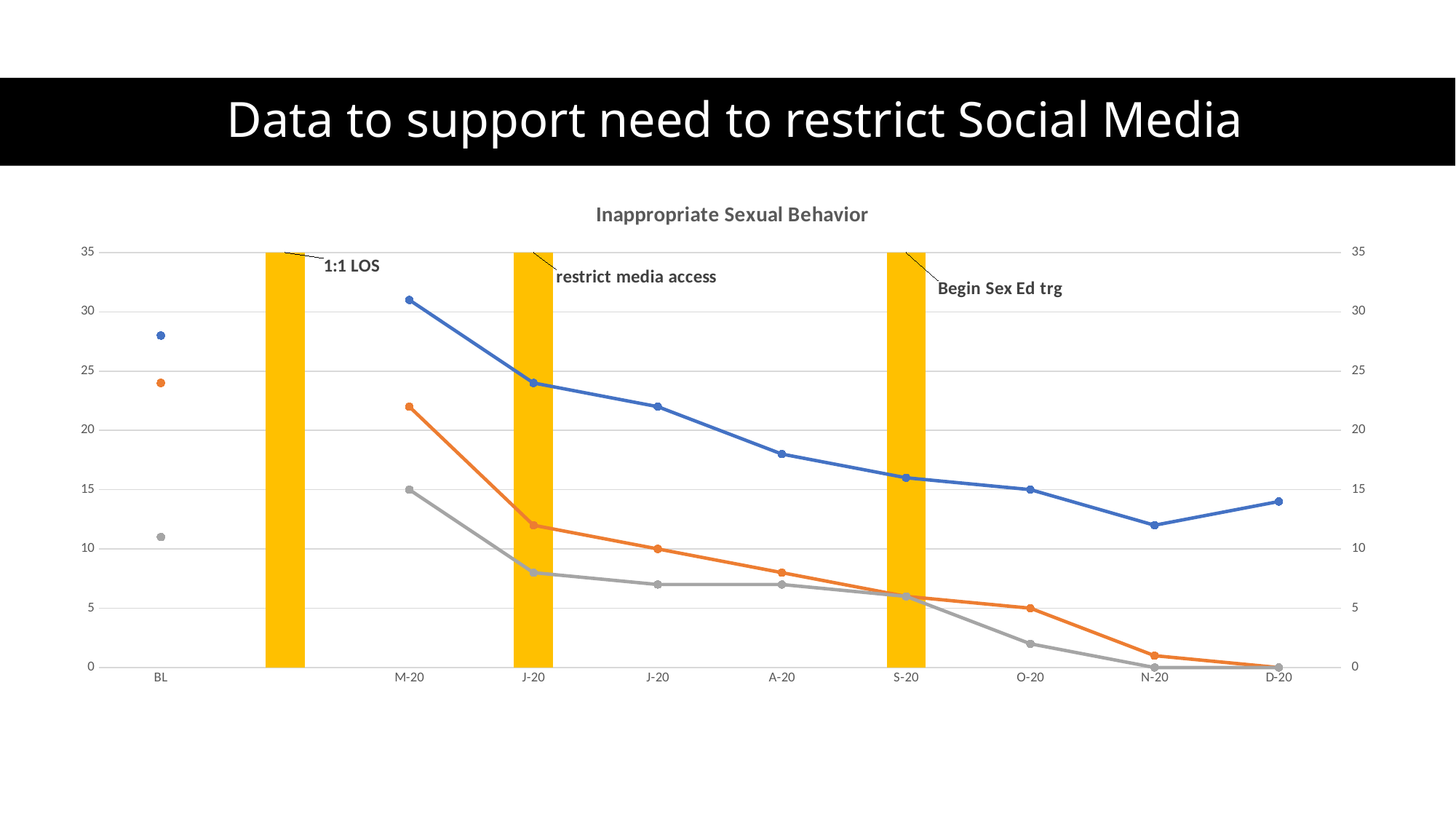
What type of chart is shown on the slide? combination bar and line chart What is the value of the blue series at O-20? 15 What is the value of the gray series at M-20? 15 What is the value of the orange series at O-20? 5 At BL, which is larger: the blue series value or the orange series value? the blue series What is the value of the gray series at D-20? 0 How many categories are shown on the x axis of the chart? 9 Which series has the highest value at M-20? the blue series Is the value of the blue series at M-20 greater or less than 30? greater How many data series (lines) are plotted on the chart? 3 What is the title of the chart? Inappropriate Sexual Behavior Is the value of the blue series at N-20 greater or less than 10? greater